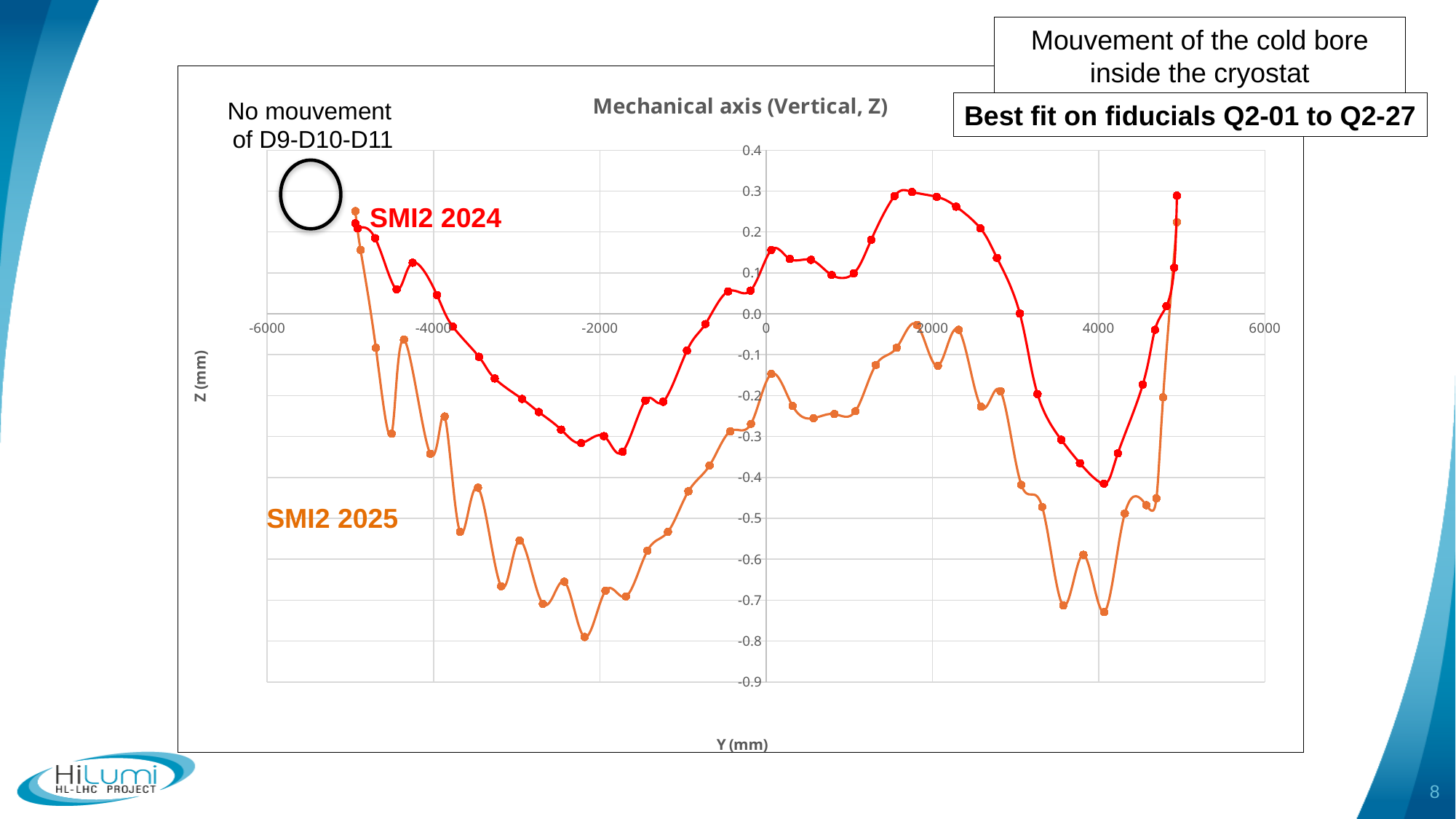
What is the title of the chart? Mechanical axis (Vertical, Z) What kind of chart is shown on the slide? line chart What is the label of the horizontal axis of the chart? Y (mm) Which series reaches the lowest Z value on the chart? SMI2 2025 Is the SMI2 2025 value at Y = 4000 greater or less than -0.5? less Is the highest value reached by the SMI2 2024 series greater or less than 0.2? greater Is the SMI2 2024 value at Y = -5000 greater or less than 0.1? greater How many data series are plotted on the chart? 2 Between Y = -2000 and Y = 2000, does the SMI2 2024 series generally rise or fall? rise At Y = 0, which series has the higher Z value, SMI2 2024 or SMI2 2025? SMI2 2024